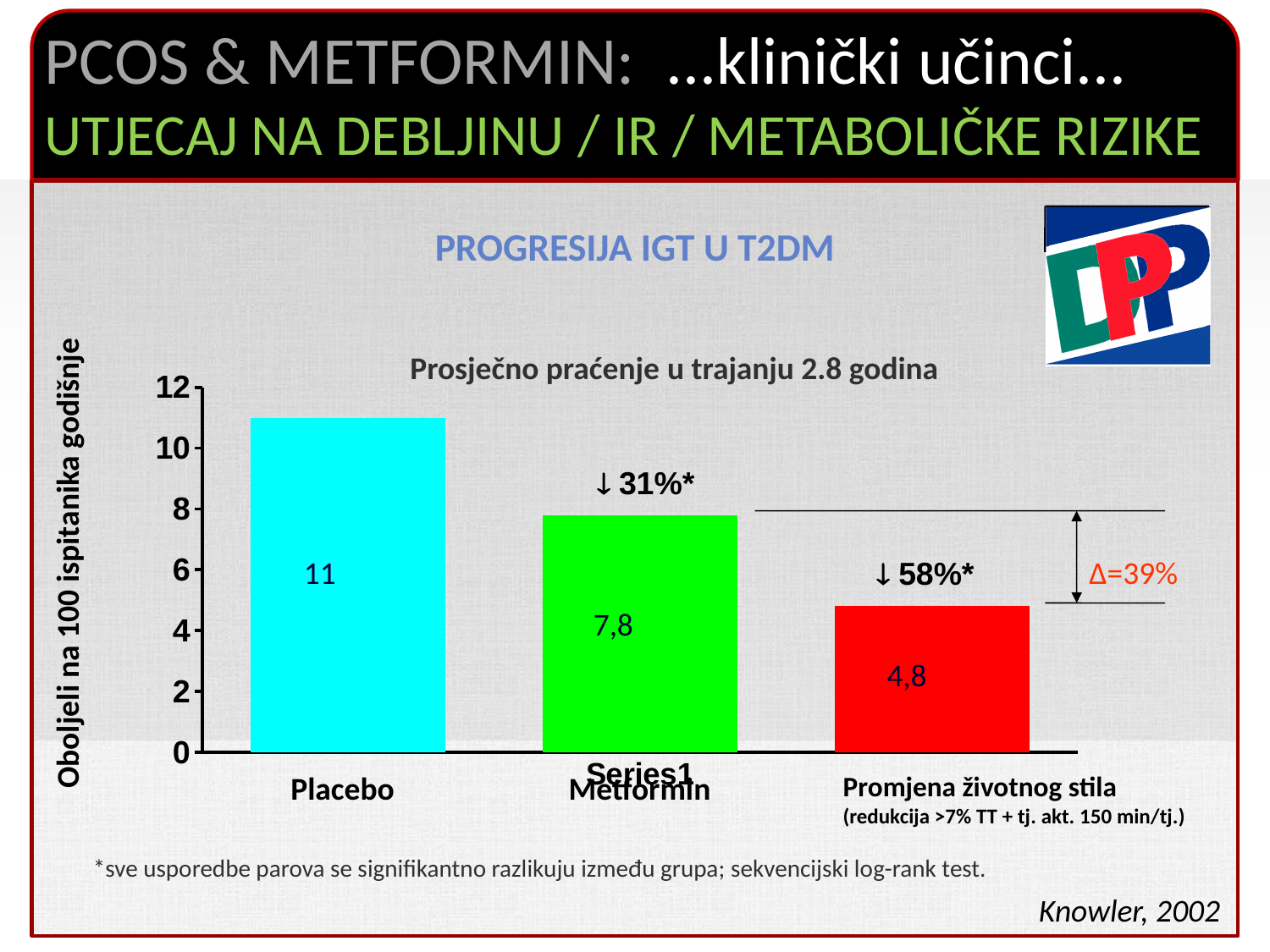
What is the value for Promjena životnog stila? 4,8 Which category has the lowest value? Promjena životnog stila What kind of chart is shown on the slide? bar chart Which category has the highest value? Placebo What is the value for Placebo? 11 Which is larger, the value for Metformin or the value for Promjena životnog stila? Metformin What is the title of the chart? PROGRESIJA IGT U T2DM What is the difference between the values for Metformin and Promjena životnog stila? 3 What is the difference between the values for Placebo and Metformin? 3,2 How many bars are shown in the chart? 3 What is the value for Metformin? 7,8 Is the value for Placebo greater or less than 10? greater